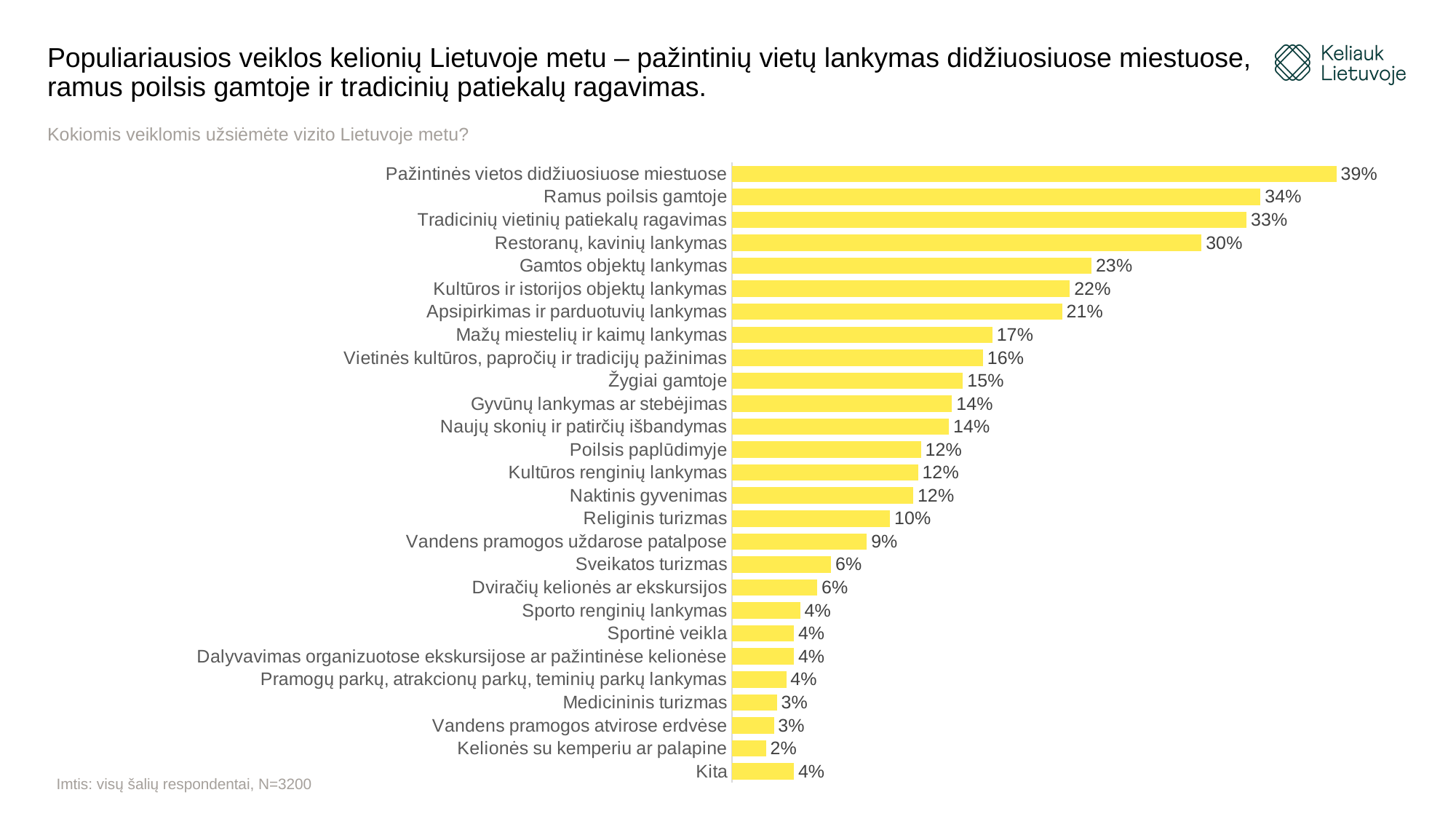
How many activity categories are shown on the chart? 27 What is the difference between "Pažintinės vietos didžiuosiuose miestuose" and "Restoranų, kavinių lankymas"? 9% What is the difference between "Gamtos objektų lankymas" and "Žygiai gamtoje"? 8% What percentage of respondents chose "Ramus poilsis gamtoje"? 34% Which is larger: "Sveikatos turizmas" or "Medicininis turizmas"? Sveikatos turizmas Which activity has the lowest value on the chart? Kelionės su kemperiu ar palapine What is the value shown for "Vandens pramogos uždarose patalpose"? 9% Which activity has the highest value on the chart? Pažintinės vietos didžiuosiuose miestuose What is the sample size stated at the bottom of the slide? N=3200 Which is larger: "Apsipirkimas ir parduotuvių lankymas" or "Mažų miestelių ir kaimų lankymas"? Apsipirkimas ir parduotuvių lankymas What type of chart is shown on the slide? Bar chart What is the value shown for "Religinis turizmas"? 10%